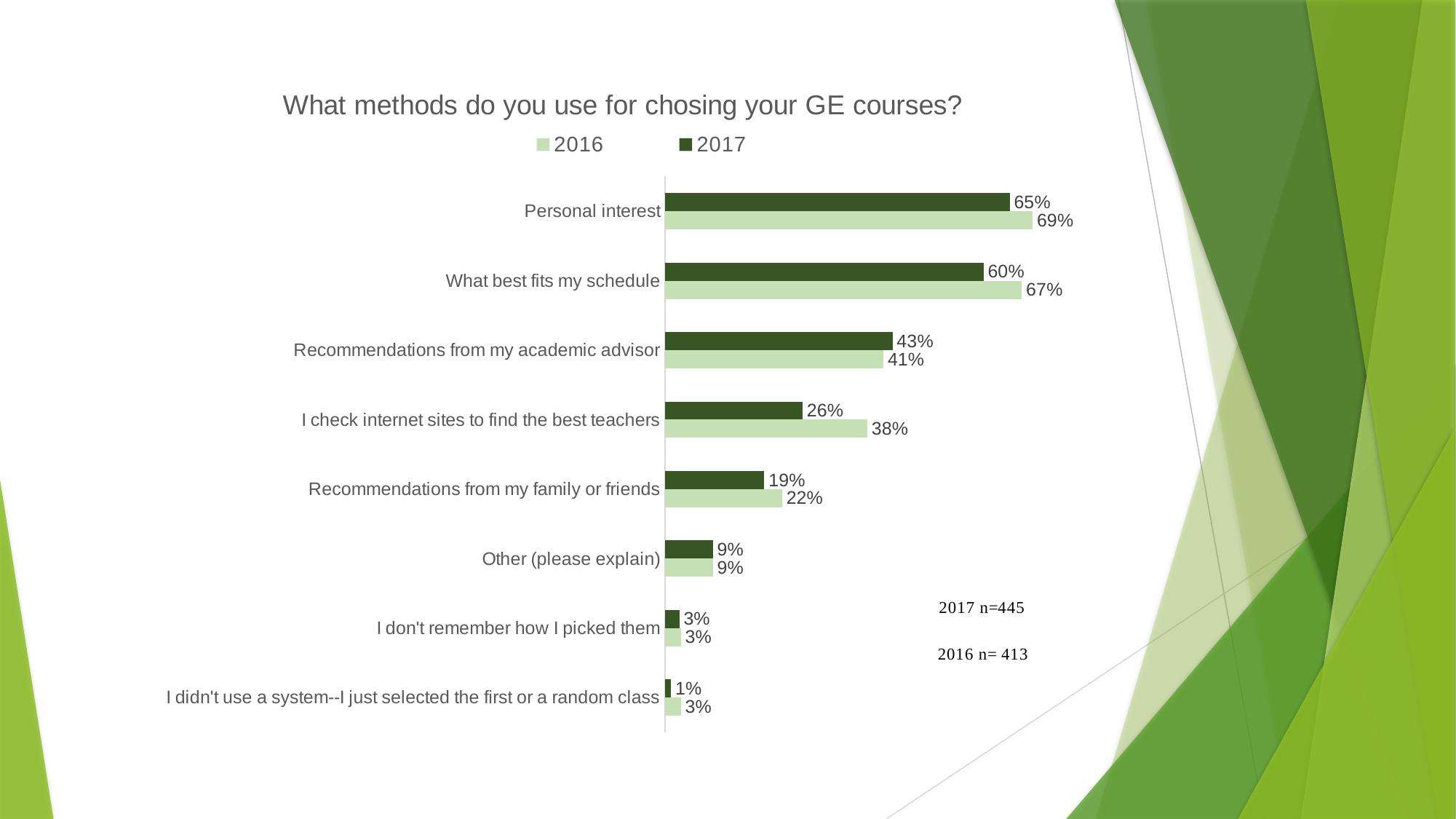
What is the 2016 value for I check internet sites to find the best teachers? 38% How many categories are shown in the chart? 8 What kind of chart is shown on the slide? Bar chart Which is larger for Recommendations from my academic advisor, the 2016 value or the 2017 value? 2017 Which category has the lowest 2017 value? I didn't use a system--I just selected the first or a random class What is the difference between the 2016 and 2017 values for I check internet sites to find the best teachers? 12% What is the title of the chart? What methods do you use for chosing your GE courses? What is the 2017 value for Personal interest? 65% What is the 2017 value for Recommendations from my academic advisor? 43% Which category has the highest 2016 value? Personal interest How many series does the legend list? 2 What is the difference between the 2016 and 2017 values for What best fits my schedule? 7%